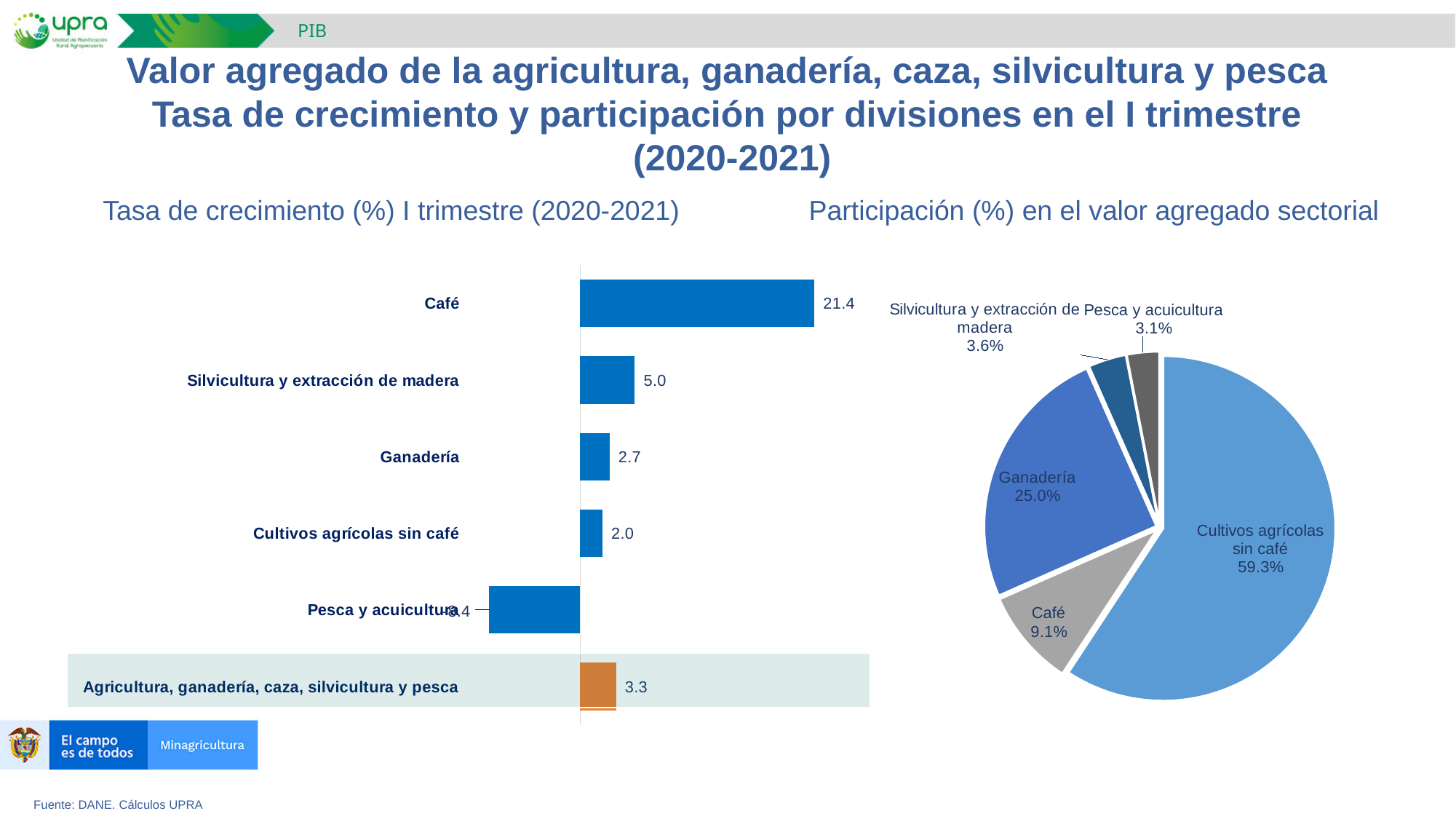
In the bar chart 'Tasa de crecimiento (%) I trimestre (2020-2021)', which category has the highest growth rate? Café In the pie chart 'Participación (%) en el valor agregado sectorial', what is the share for Ganadería? 25.0% In the bar chart 'Tasa de crecimiento (%) I trimestre (2020-2021)', which is larger: the value for Ganadería or for Cultivos agrícolas sin café? Ganadería How many categories are shown in the bar chart 'Tasa de crecimiento (%) I trimestre (2020-2021)'? 6 In the bar chart 'Tasa de crecimiento (%) I trimestre (2020-2021)', what is the growth rate for Café? 21.4 In the bar chart 'Tasa de crecimiento (%) I trimestre (2020-2021)', which category has the lowest growth rate? Pesca y acuicultura In the pie chart 'Participación (%) en el valor agregado sectorial', what share does Cultivos agrícolas sin café have? 59.3% In the bar chart 'Tasa de crecimiento (%) I trimestre (2020-2021)', what is the difference between the values for Café and Ganadería? 18.7 In the pie chart 'Participación (%) en el valor agregado sectorial', which slice is the smallest? Pesca y acuicultura In the bar chart 'Tasa de crecimiento (%) I trimestre (2020-2021)', what is the value for Agricultura, ganadería, caza, silvicultura y pesca? 3.3 What kind of chart is 'Participación (%) en el valor agregado sectorial'? Pie chart In the bar chart 'Tasa de crecimiento (%) I trimestre (2020-2021)', what is the value for Silvicultura y extracción de madera? 5.0